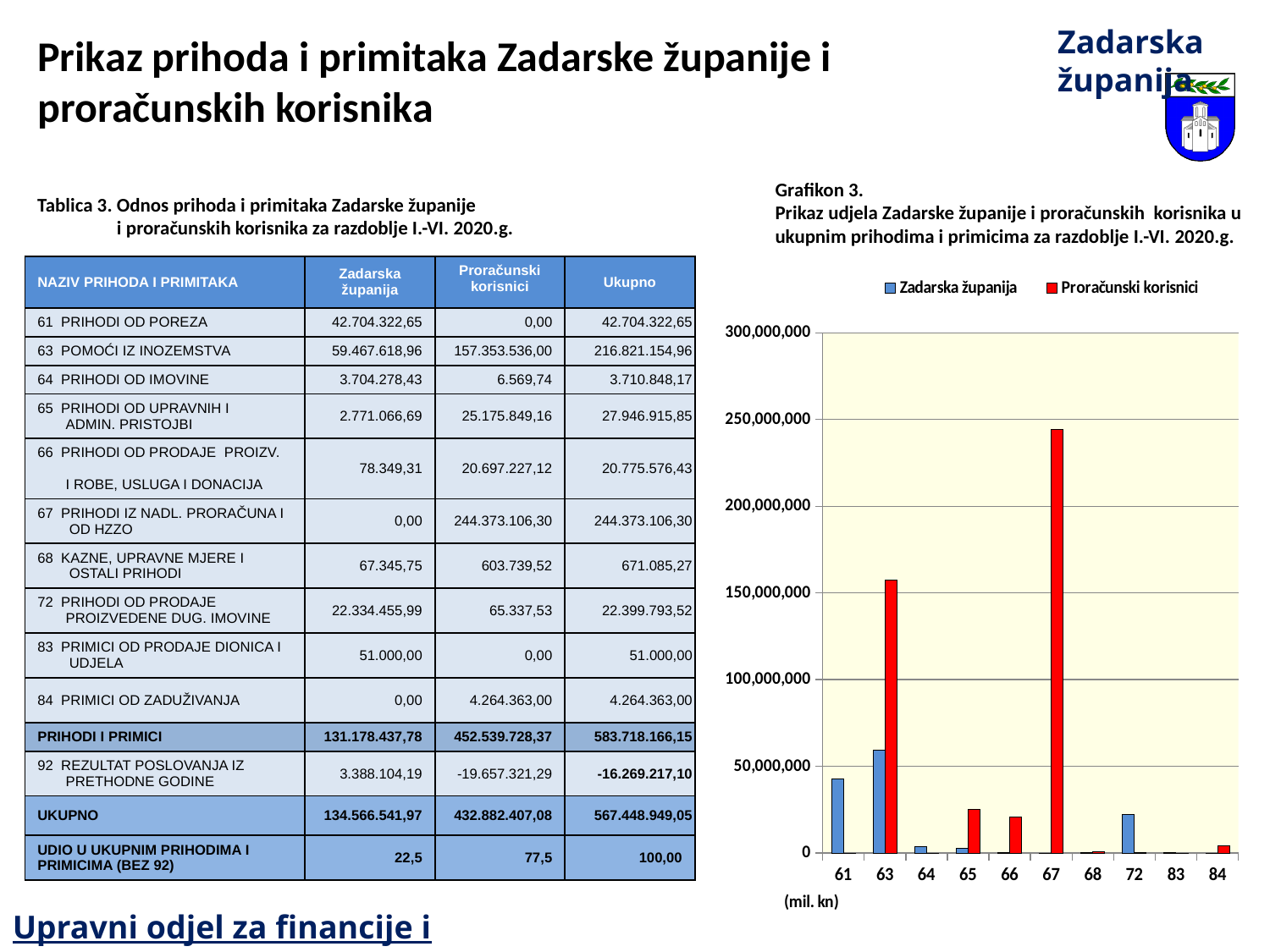
How many series does the legend of Grafikon 3 list? 2 In Grafikon 3, for category 63, which series has the larger value: Zadarska županija or Proračunski korisnici? Proračunski korisnici What type of chart is shown in Grafikon 3? bar chart In Grafikon 3, which category has the highest value for Proračunski korisnici? 67 How many categories are shown on the x axis of Grafikon 3? 10 In Grafikon 3, is the Zadarska županija value for category 61 greater or less than 50,000,000? less In Grafikon 3, is the Proračunski korisnici value for category 63 greater or less than 100,000,000? greater In Grafikon 3, for category 61, which series has the larger value: Zadarska županija or Proračunski korisnici? Zadarska županija In Grafikon 3, which colour represents the Proračunski korisnici series? red In Grafikon 3, is the Proračunski korisnici value for category 67 greater or less than 200,000,000? greater In Grafikon 3, which category has the highest value for Zadarska županija? 63